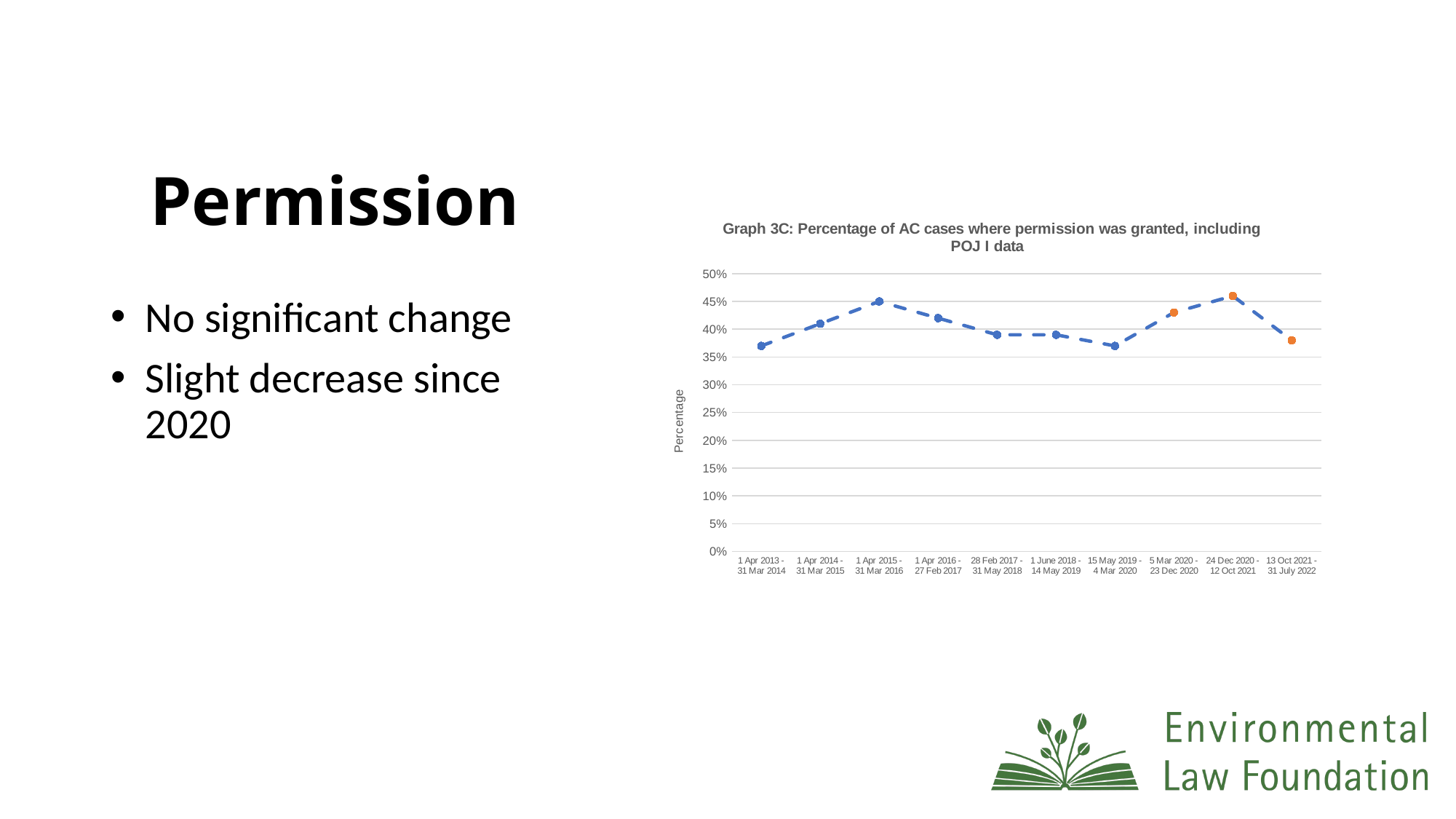
Is the value for 1 Apr 2015 - 31 Mar 2016 greater or less than 40%? greater Is the value for 24 Dec 2020 - 12 Oct 2021 greater or less than 40%? greater What is the title of the chart? Graph 3C: Percentage of AC cases where permission was granted, including POJ I data Is the value for 15 May 2019 - 4 Mar 2020 greater or less than 40%? less Which is larger: the value for 24 Dec 2020 - 12 Oct 2021 or the value for 13 Oct 2021 - 31 July 2022? 24 Dec 2020 - 12 Oct 2021 What is the label on the vertical axis of the chart? Percentage Do the values rise or fall from 1 Apr 2013 - 31 Mar 2014 to 1 Apr 2015 - 31 Mar 2016? rise Which is larger: the value for 1 Apr 2015 - 31 Mar 2016 or the value for 1 Apr 2013 - 31 Mar 2014? 1 Apr 2015 - 31 Mar 2016 How many data points are plotted on the chart? 10 What kind of chart is shown on the slide? line chart